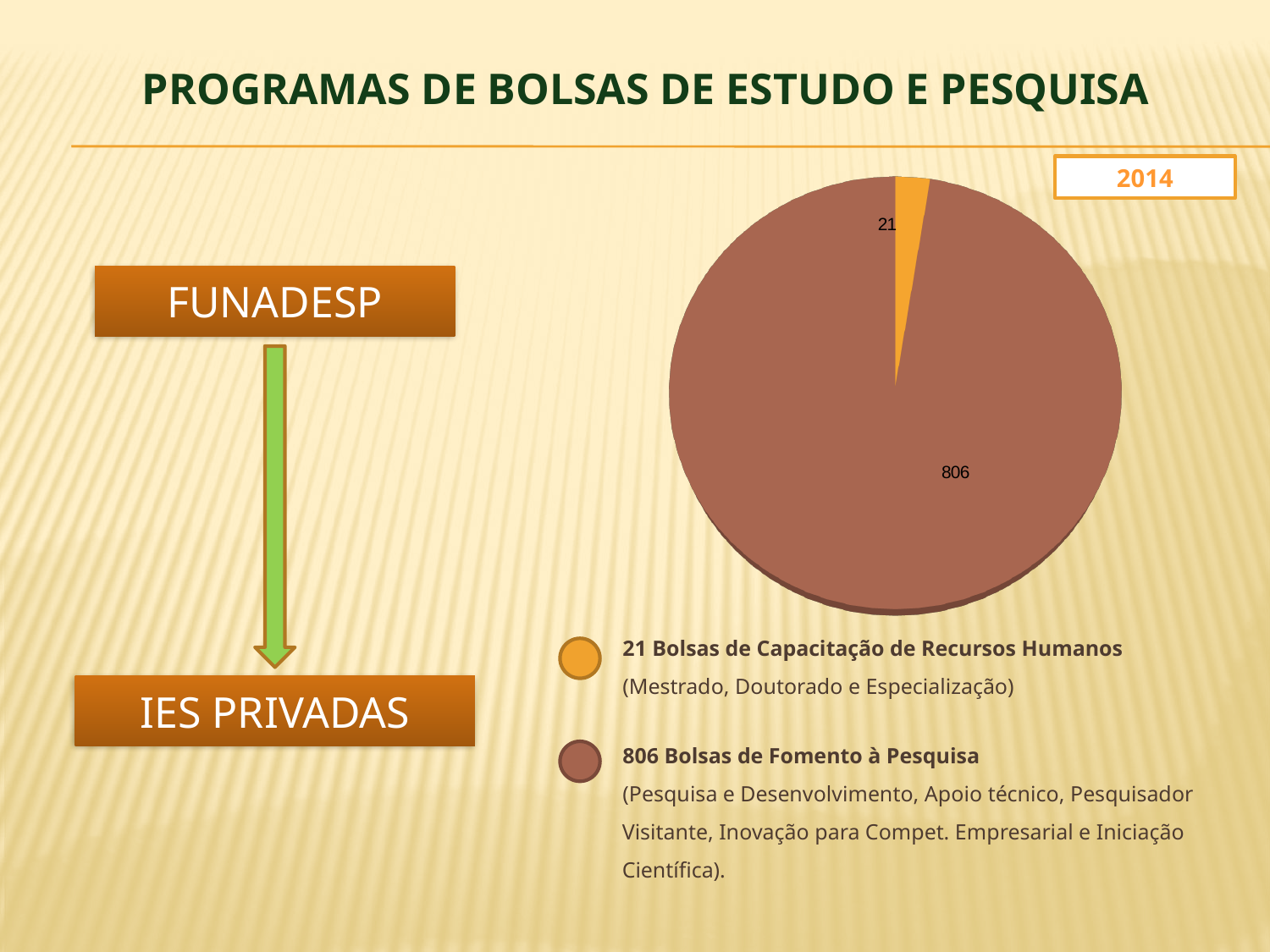
How many slices does the pie chart have? 2 Which year does the pie chart refer to? 2014 What is the value of the brown slice (Bolsas de Fomento à Pesquisa)? 806 Which is larger: Bolsas de Fomento à Pesquisa or Bolsas de Capacitação de Recursos Humanos? Bolsas de Fomento à Pesquisa What colour is the slice for Bolsas de Capacitação de Recursos Humanos? orange What is the total number of bolsas represented in the pie chart? 827 What is the value of the orange slice (Bolsas de Capacitação de Recursos Humanos)? 21 What kind of chart is shown on the slide? pie chart What is the difference between the number of Bolsas de Fomento à Pesquisa and Bolsas de Capacitação de Recursos Humanos? 785 What share of the pie do the 806 Bolsas de Fomento à Pesquisa represent, to one decimal place? 97.5% Which category has the largest slice in the pie chart? Bolsas de Fomento à Pesquisa Which category has the smallest slice in the pie chart? Bolsas de Capacitação de Recursos Humanos